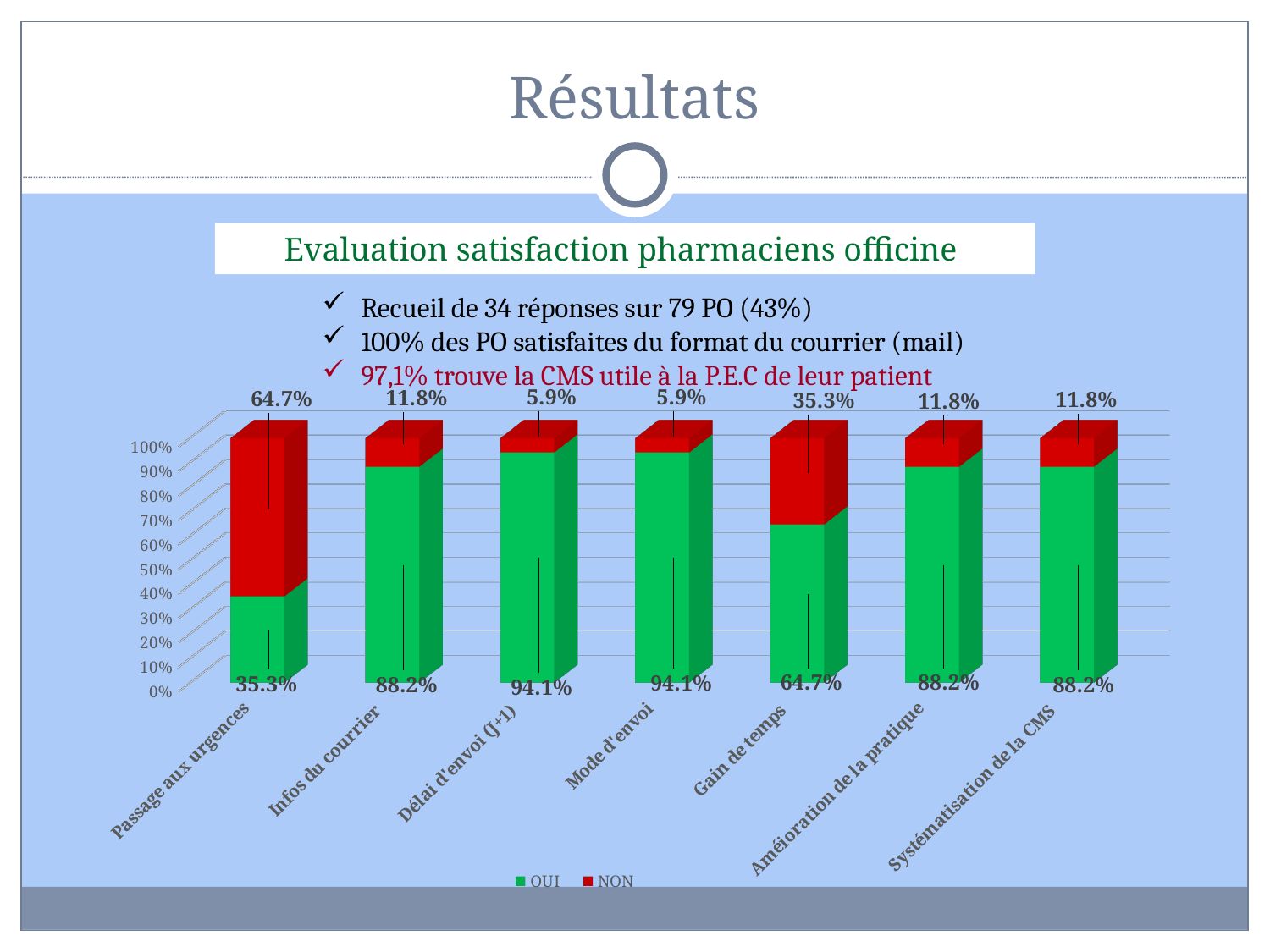
What is the difference between the OUI values for Infos du courrier and Gain de temps? 23.5% Which category has the lowest OUI value? Passage aux urgences Which category has the highest NON value? Passage aux urgences What is the OUI value for Délai d'envoi (J+1)? 94.1% How many categories are shown on the x axis? 7 How many series does the legend list? 2 What kind of chart is shown on the slide? Stacked bar chart What is the NON value for Systématisation de la CMS? 11.8% What are the two series named in the legend? OUI and NON What is the OUI value for Passage aux urgences? 35.3% What is the NON value for Gain de temps? 35.3% Which is larger, the OUI value for Mode d'envoi or the OUI value for Amélioration de la pratique? Mode d'envoi